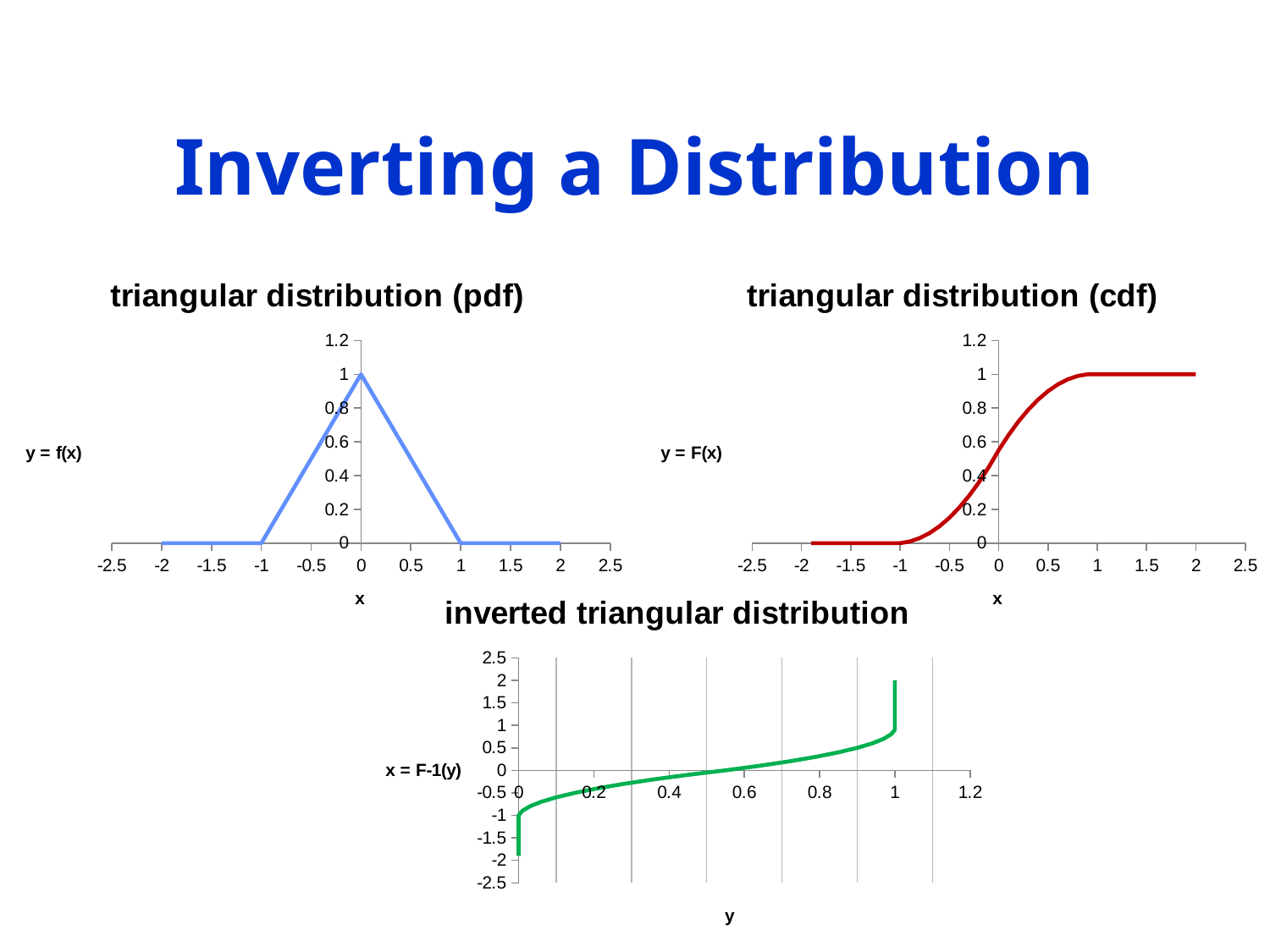
In the "inverted triangular distribution" chart, what is the label of the horizontal axis? y How many charts are shown on the slide? 3 In the "triangular distribution (cdf)" chart, do the values rise or fall as x increases from -1 to 1? rise In the "triangular distribution (pdf)" chart, what is the value of y = f(x) at x = 1? 0 What kind of chart is the "triangular distribution (pdf)" chart? line chart In the "triangular distribution (cdf)" chart, what is the value of y = F(x) at x = -1? 0 In the "triangular distribution (pdf)" chart, is the value at x = -0.5 greater or less than 0.2? greater In the "triangular distribution (cdf)" chart, what is the value of y = F(x) at x = 1? 1 In the "triangular distribution (cdf)" chart, is the value at x = 0.5 greater or less than 0.6? greater In the "triangular distribution (pdf)" chart, what is the value of y = f(x) at x = 0? 1 In the "triangular distribution (pdf)" chart, at which x value is y = f(x) highest? 0